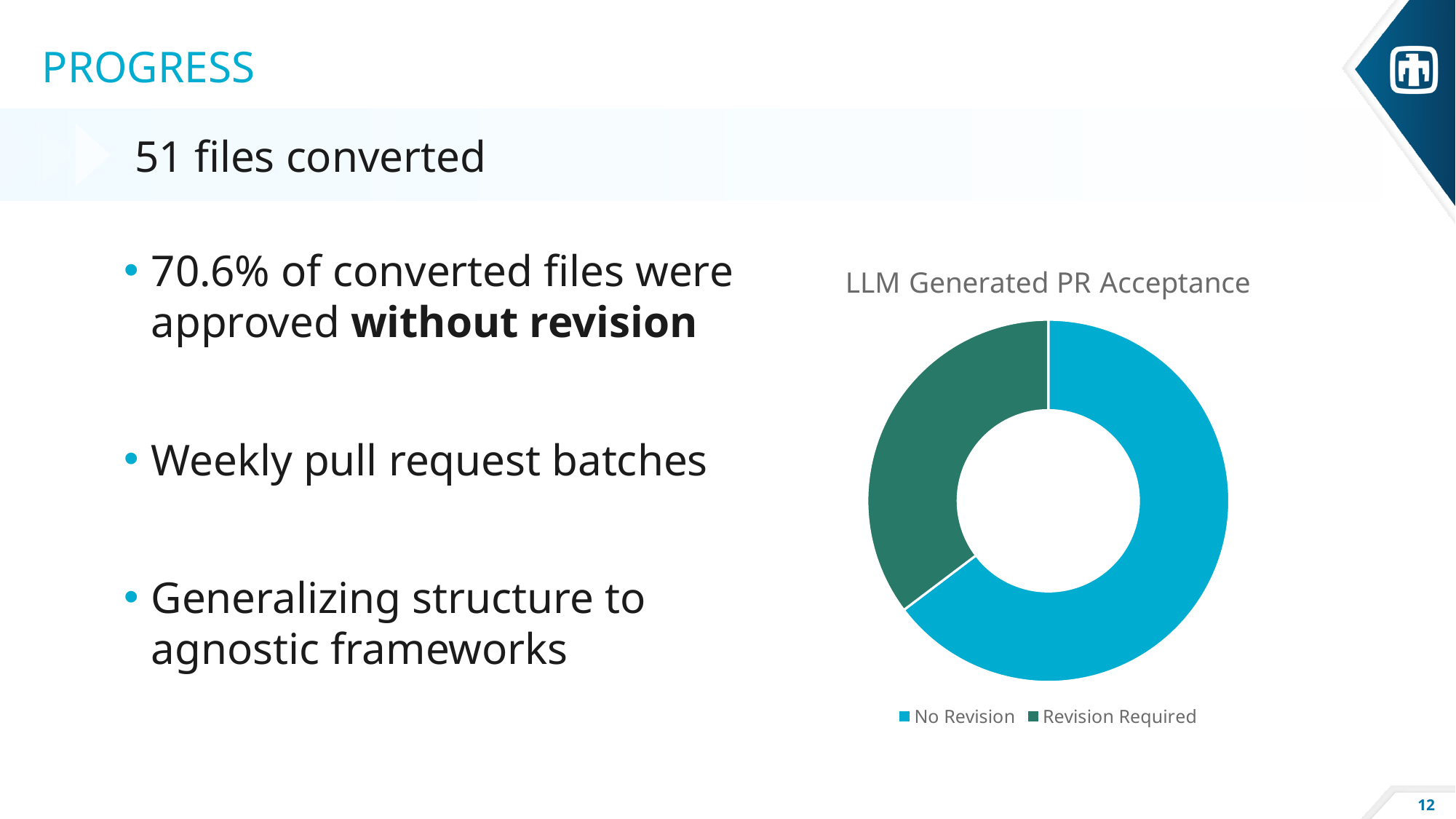
What colour represents the No Revision slice? Blue Is the No Revision slice greater or less than half of the chart? greater How many entries does the chart legend list? 2 What is the title of the chart? LLM Generated PR Acceptance Which category takes up the smallest share of the chart? Revision Required Is the Revision Required slice greater or less than half of the chart? less Which category takes up the largest share of the chart? No Revision What kind of chart is shown on the slide? Doughnut chart Which slice is larger, No Revision or Revision Required? No Revision How many slices does the chart have? 2